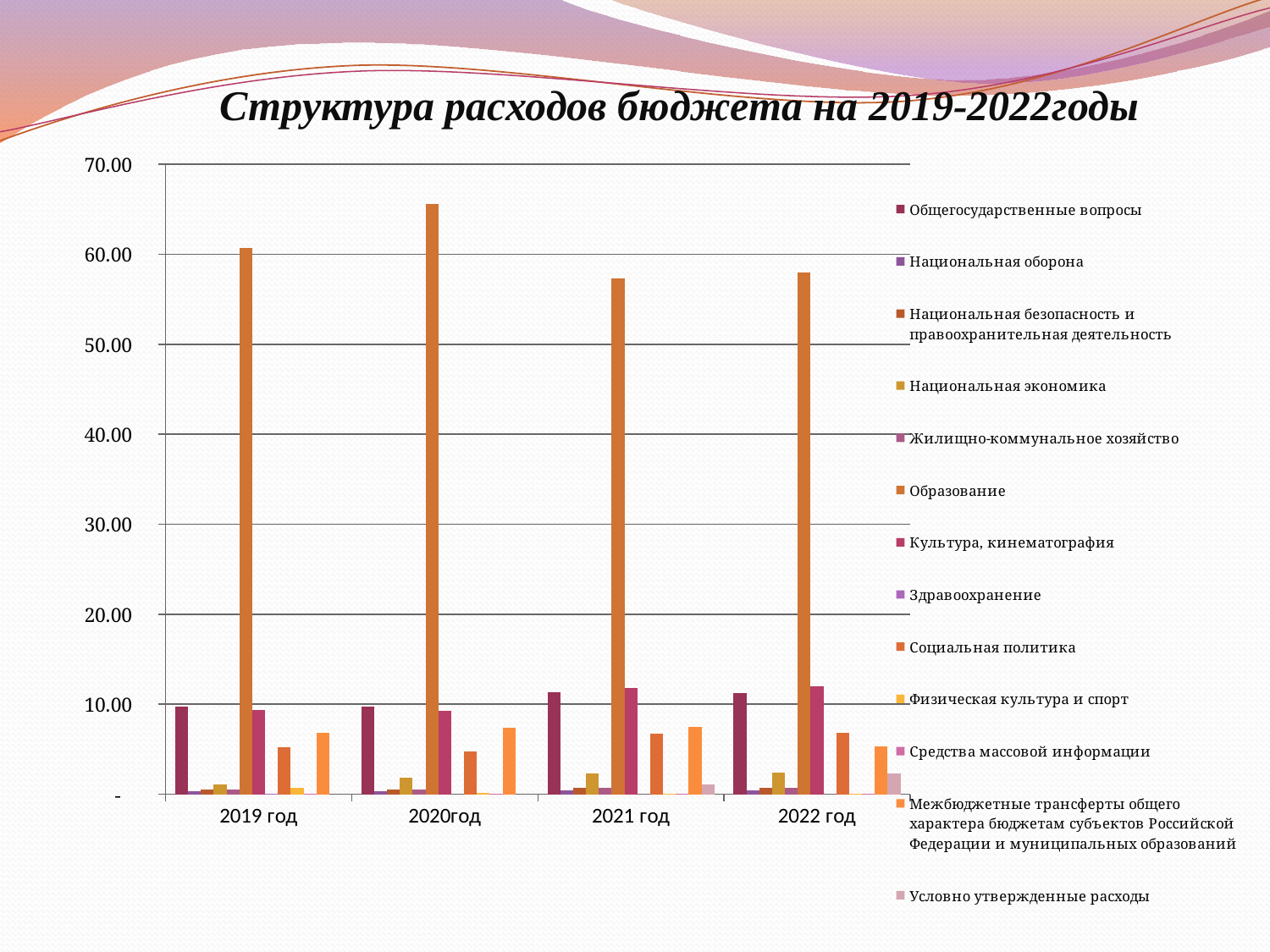
Which is larger for Образование: 2019 год or 2020год? 2020год Which is larger in 2019 год: Общегосударственные вопросы or Социальная политика? Общегосударственные вопросы What kind of chart is shown on the slide? bar chart Is the value for Социальная политика in 2019 год greater or less than 10? less How many series does the legend list? 13 How many year categories are shown on the x axis? 4 Is the value for Образование in 2021 год greater or less than 60? less In which year is the bar for Образование the highest? 2020год Is the value for Образование in 2020год greater or less than 60? greater Which series has the tallest bar in every year? Образование What is the title of the chart? Структура расходов бюджета на 2019-2022годы Which is larger in 2022 год: Культура, кинематография or Социальная политика? Культура, кинематография